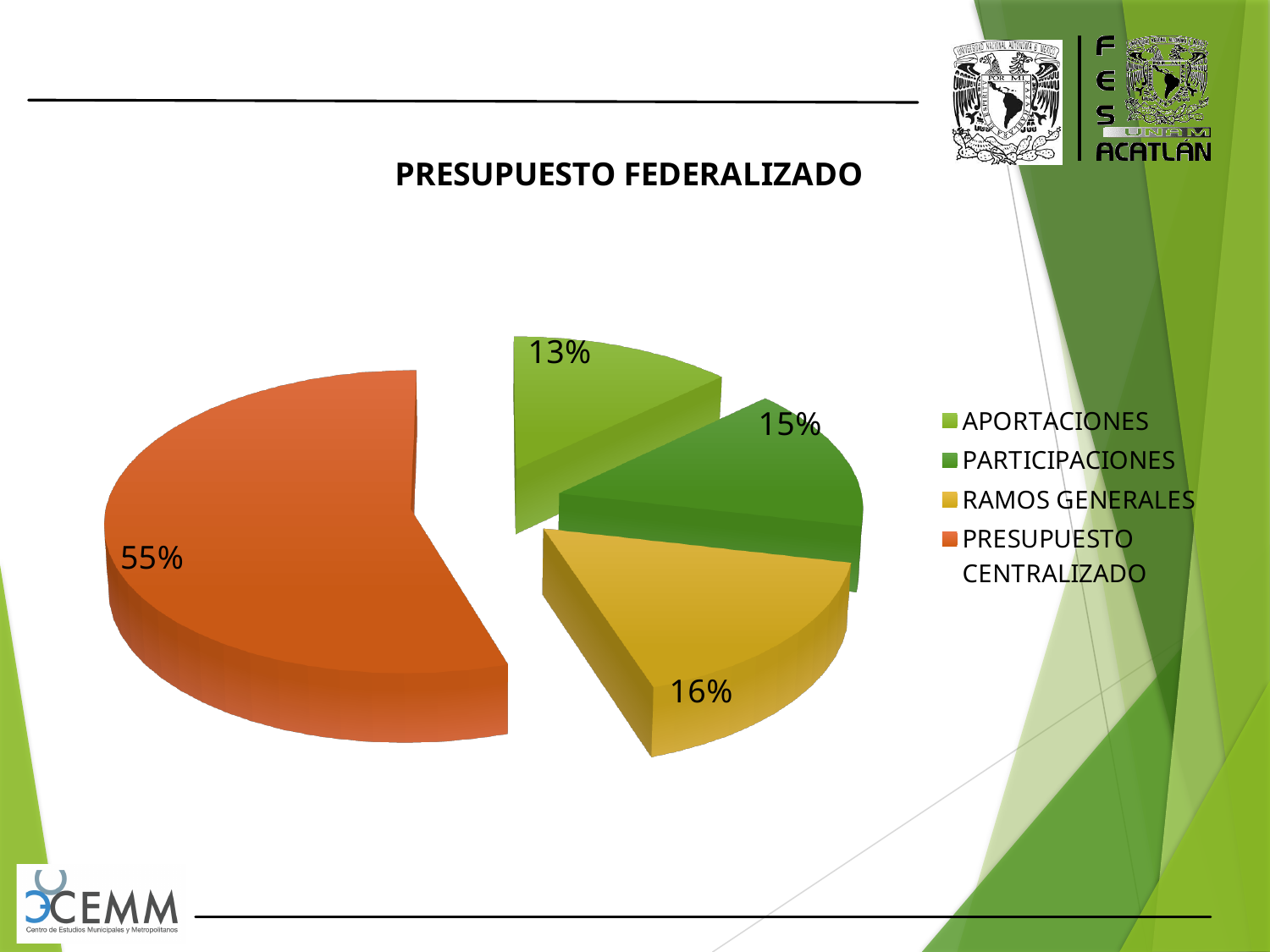
What percentage does the PARTICIPACIONES slice represent? 15% How many categories does the legend list? 4 What type of chart is shown on the slide? Pie chart What percentage does the RAMOS GENERALES slice represent? 16% Which category has the largest share of the pie? PRESUPUESTO CENTRALIZADO What percentage does the APORTACIONES slice represent? 13% What is the difference in percentage points between PRESUPUESTO CENTRALIZADO and RAMOS GENERALES? 39 What is the title of the chart? PRESUPUESTO FEDERALIZADO What colour is the PRESUPUESTO CENTRALIZADO slice? Orange Which category has the smallest share of the pie? APORTACIONES Which is larger, the share for RAMOS GENERALES or the share for APORTACIONES? RAMOS GENERALES What percentage does the PRESUPUESTO CENTRALIZADO slice represent? 55%